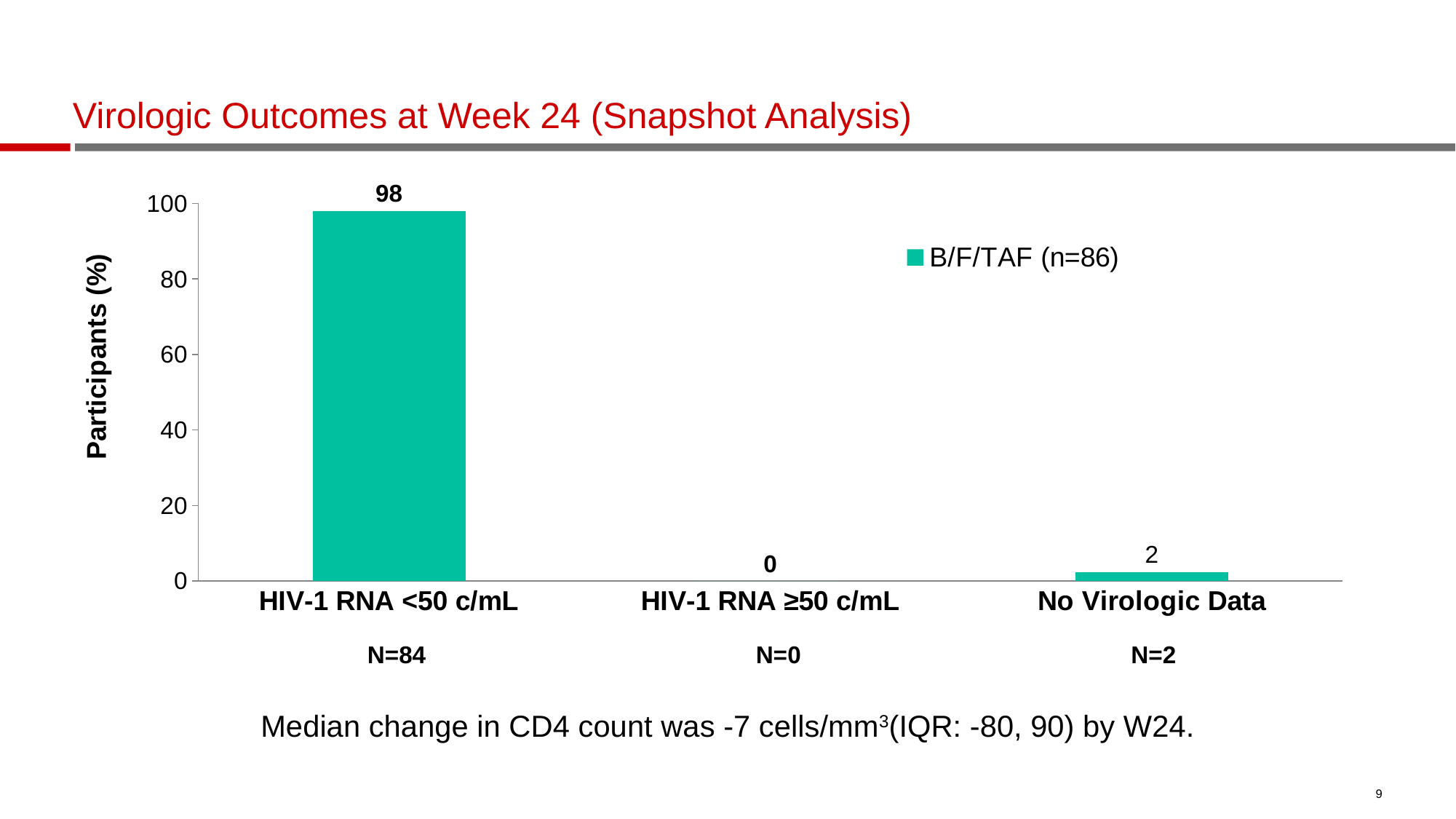
Is the value for HIV-1 RNA <50 c/mL greater or less than 80? greater Which is larger, the value for No Virologic Data or the value for HIV-1 RNA ≥50 c/mL? No Virologic Data What percentage of participants had HIV-1 RNA ≥50 c/mL? 0 Which category has the highest percentage of participants? HIV-1 RNA <50 c/mL What is the difference in percentage points between HIV-1 RNA <50 c/mL and No Virologic Data? 96 What is the series name shown in the legend? B/F/TAF (n=86) What percentage of participants had HIV-1 RNA <50 c/mL? 98 What kind of chart is shown on the slide? bar chart Which category has the lowest percentage of participants? HIV-1 RNA ≥50 c/mL How many series does the legend list? 1 What percentage of participants had No Virologic Data? 2 How many categories are shown on the x axis? 3